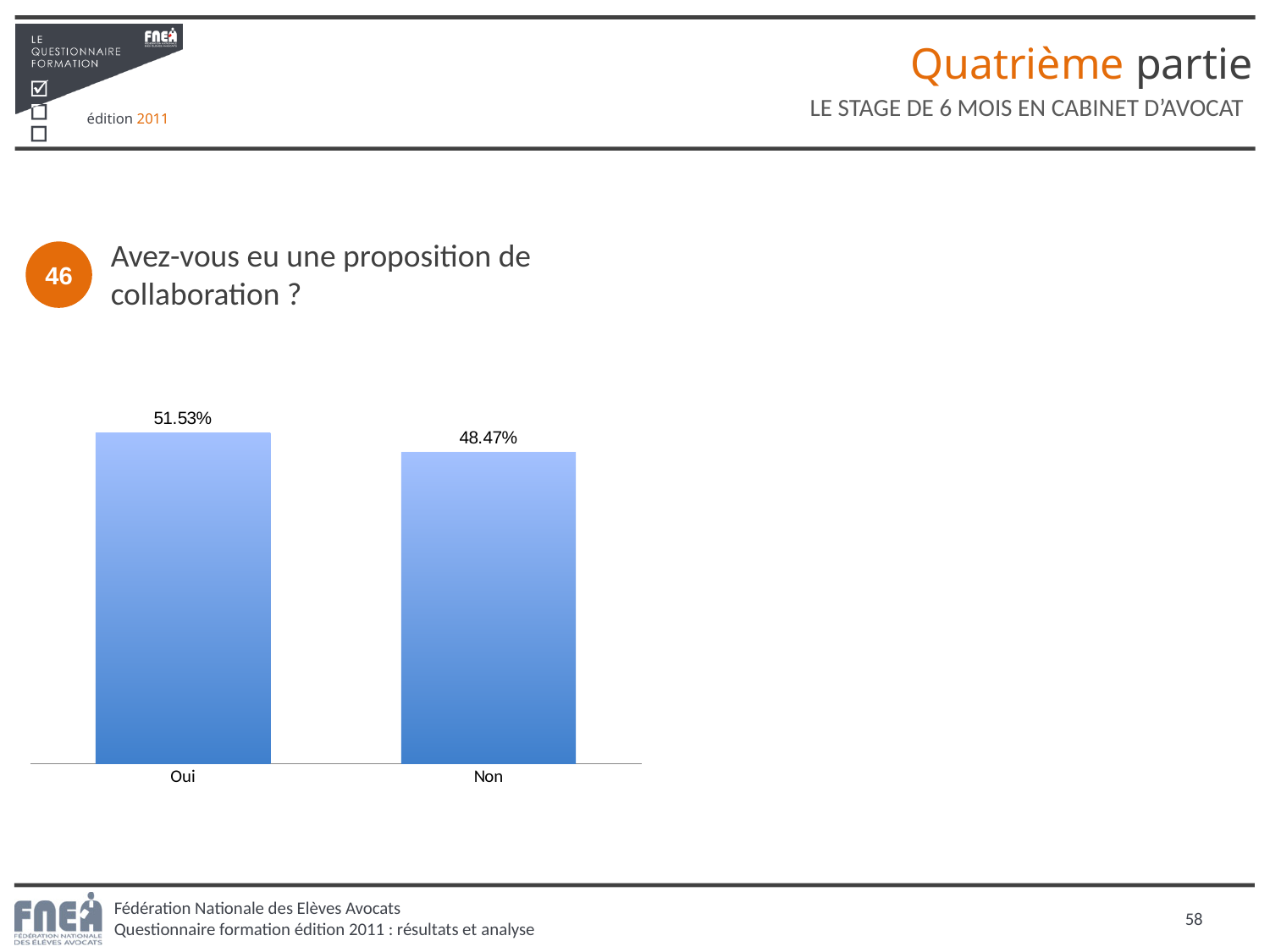
What are the category labels on the x axis of the chart? Oui and Non What is the difference between the values for Oui and Non? 3.06% Which is larger, the value for Oui or the value for Non? Oui How many categories are shown in the chart? 2 What kind of chart is shown on the slide? Bar chart Which category has the highest value? Oui Which category has the lowest value? Non What is the value for Oui? 51.53% What is the total of the two values shown in the chart? 100% What is the value for Non? 48.47% What question does the chart on the slide answer? Avez-vous eu une proposition de collaboration ?